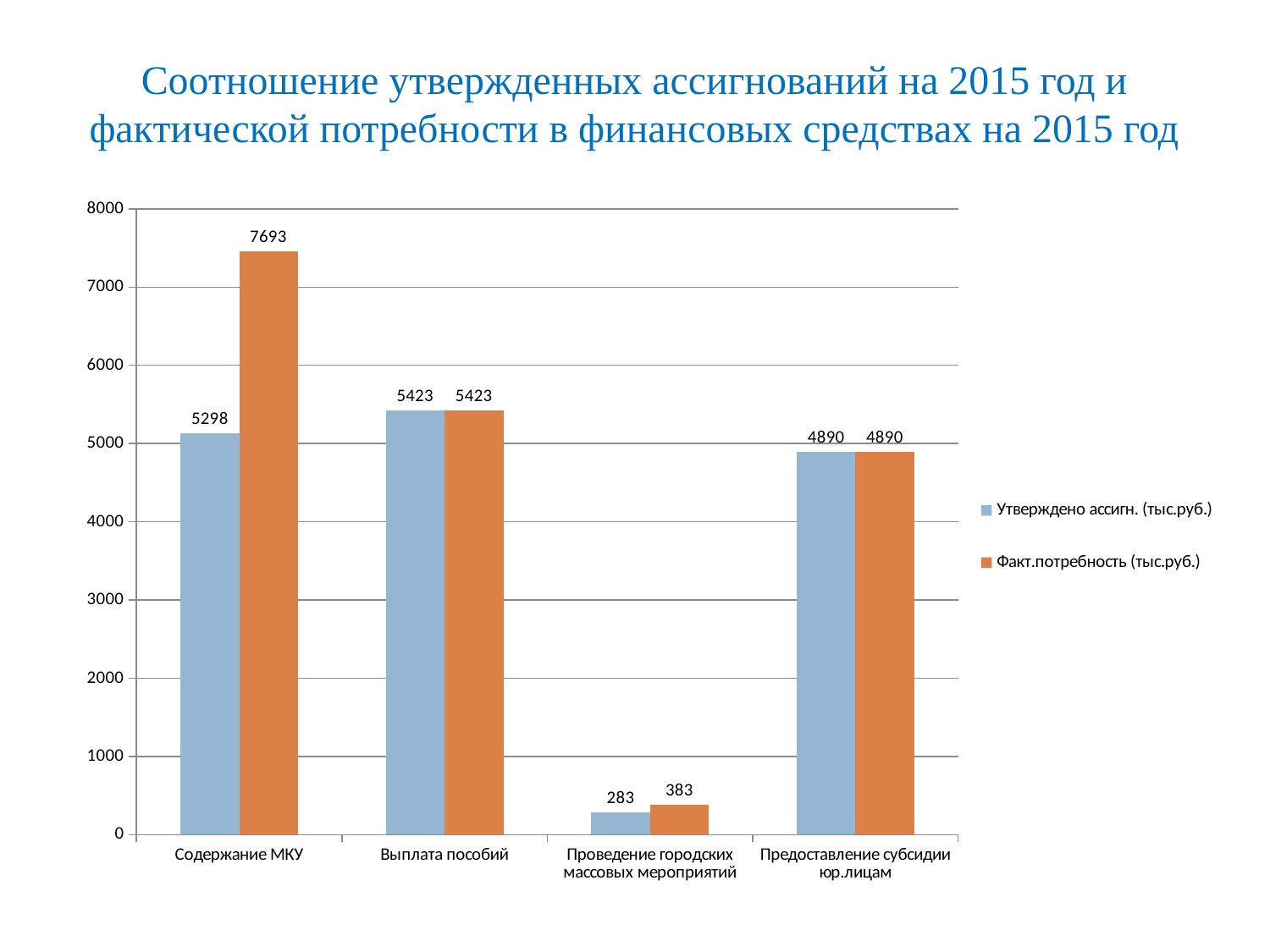
Which category has the lowest Утверждено ассигн. (тыс.руб.) value? Проведение городских массовых мероприятий How many categories are shown on the x axis? 4 What is the value of Утверждено ассигн. (тыс.руб.) for Содержание МКУ? 5298 Is the Факт.потребность value for Содержание МКУ greater or less than 7000? greater Which category has the highest Факт.потребность (тыс.руб.) value? Содержание МКУ What is the value of Факт.потребность (тыс.руб.) for Проведение городских массовых мероприятий? 383 What is the difference between Факт.потребность and Утверждено ассигн. for Содержание МКУ? 2395 What kind of chart is shown on the slide? bar chart Which is larger for Проведение городских массовых мероприятий: Утверждено ассигн. or Факт.потребность? Факт.потребность What is the value of Факт.потребность (тыс.руб.) for Содержание МКУ? 7693 How many series does the legend list? 2 What is the value of Утверждено ассигн. (тыс.руб.) for Предоставление субсидии юр.лицам? 4890